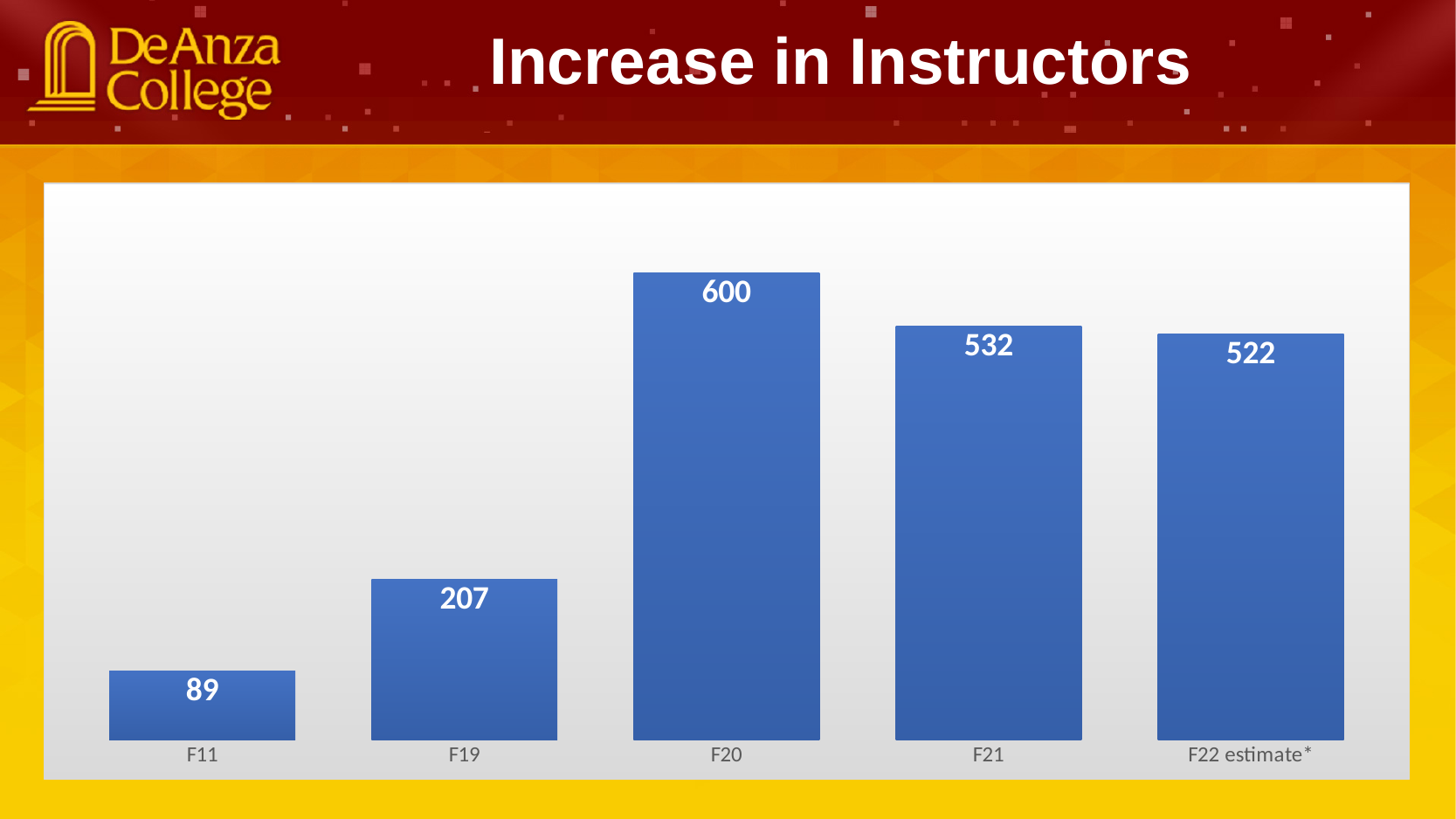
What is the value for F21? 532 What is the difference between the values for F19 and F11? 118 Which is larger, the value for F21 or the value for F22 estimate*? F21 Which category has the highest value? F20 How many categories are shown on the x axis? 5 What kind of chart is shown on the slide? Bar chart What is the value for F11? 89 Which category has the lowest value? F11 What is the value for F19? 207 What is the value for F22 estimate*? 522 What is the difference between the values for F20 and F21? 68 What is the value for F20? 600